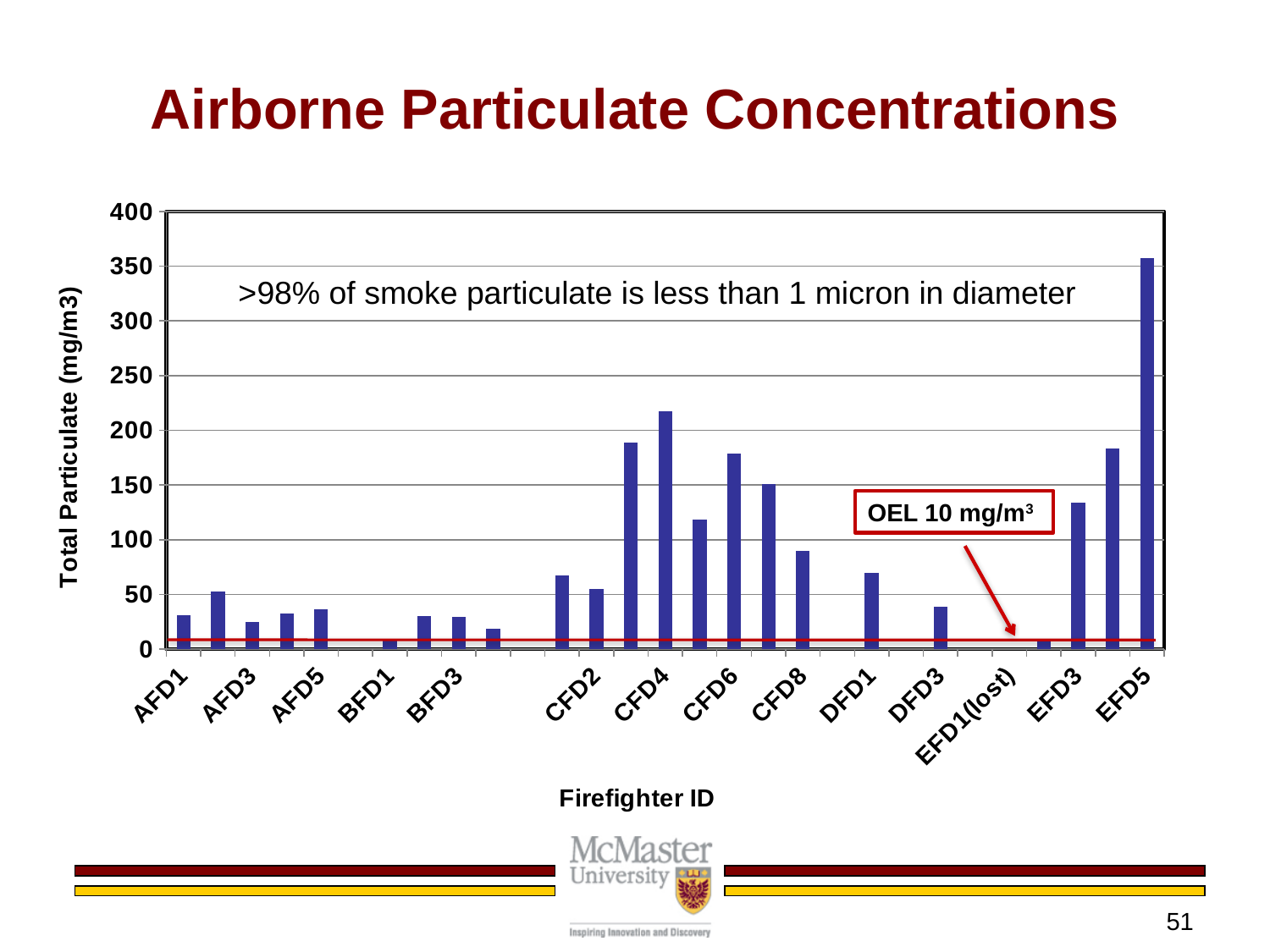
Is the value for EFD5 greater or less than 300? greater Which firefighter ID has the highest total particulate concentration? EFD5 What kind of chart is shown on the slide? bar chart Which is larger, the value for EFD5 or the value for CFD4? EFD5 Is the value for DFD1 greater or less than 50? greater Which is larger, the value for DFD1 or the value for AFD1? DFD1 Is the value for CFD6 greater or less than 200? less What OEL value is marked by the red line on the chart? OEL 10 mg/m³ What is the title of the chart's y axis? Total Particulate (mg/m3)